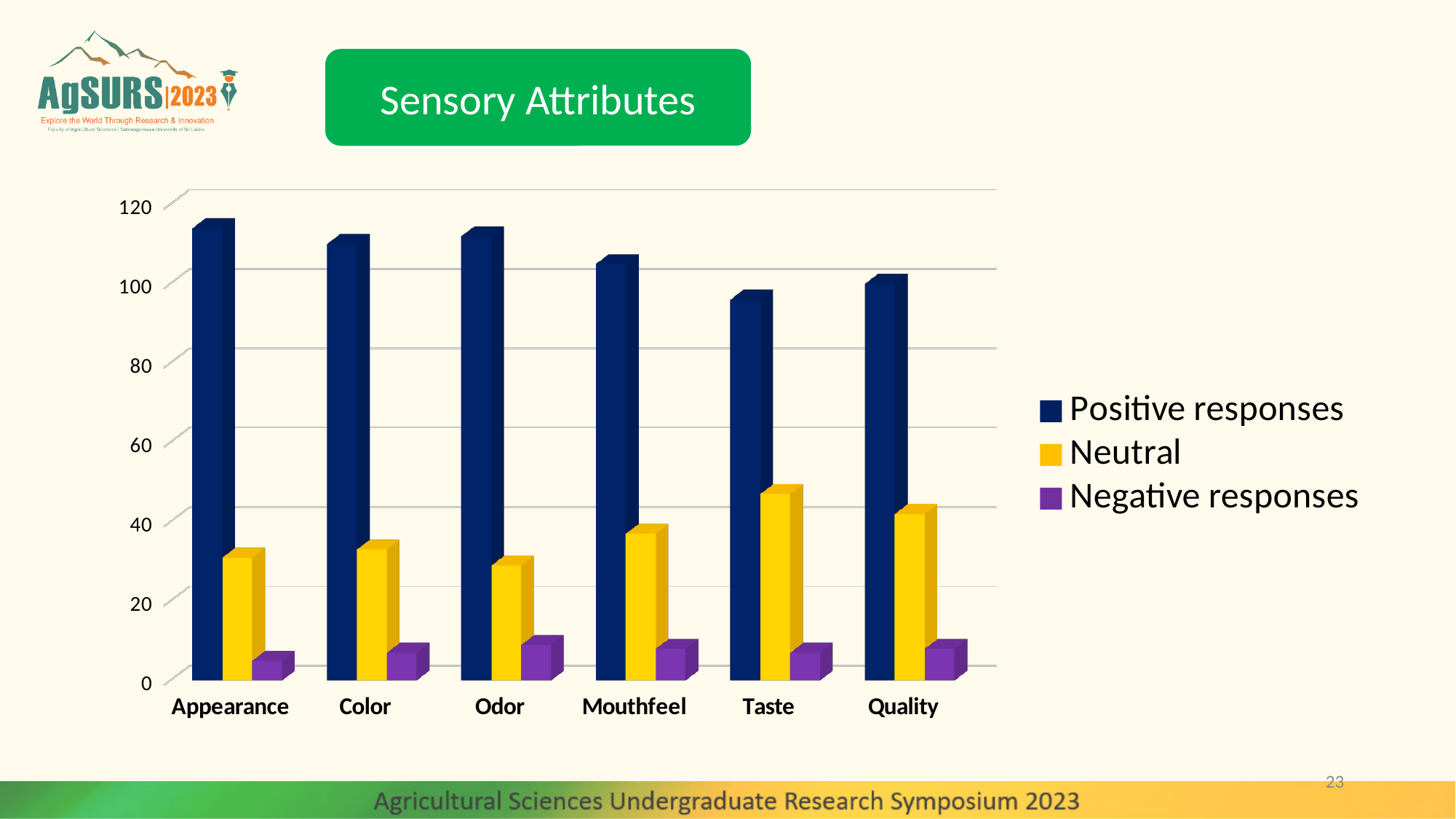
Which is larger, the Positive responses value for Appearance or for Taste? Appearance Is the Positive responses value for Appearance greater or less than 100? greater Which is larger for Quality, the Neutral value or the Negative responses value? Neutral What kind of chart is shown on the slide? bar chart Is the Positive responses value for Taste greater or less than 100? less How many sensory attribute categories are shown on the x axis? 6 Is the Neutral value for Taste greater or less than 40? greater Which category has the lowest Positive responses value? Taste Which category has the highest Neutral value? Taste What is the title shown above the chart? Sensory Attributes How many series does the legend list? 3